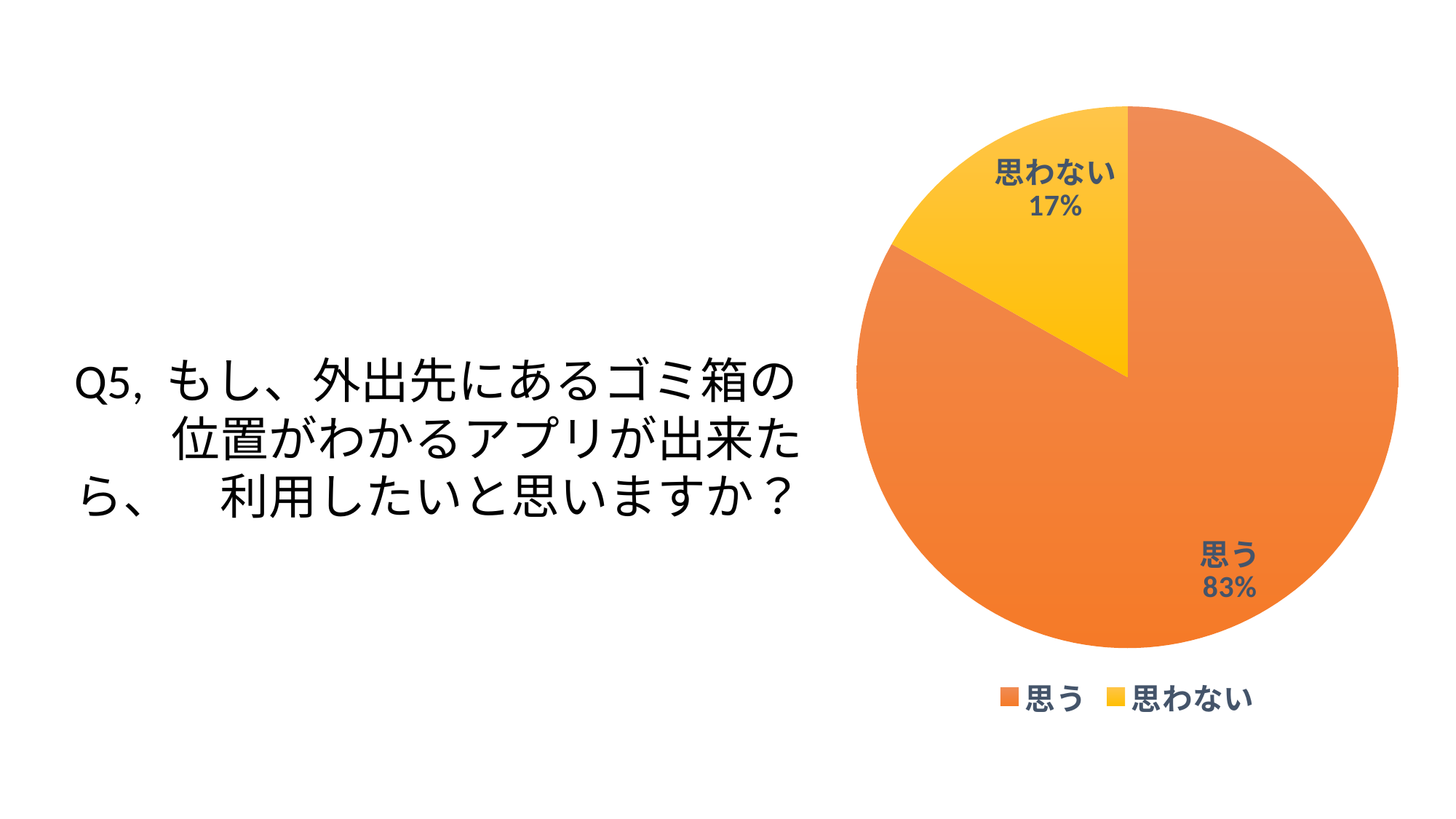
What percentage of the pie is labelled 思わない? 17% How many entries does the legend list? 2 Which legend entry is shown in yellow? 思わない What colour is the 思う slice in the pie chart? orange Which slice of the pie is the largest? 思う What share of the pie does the 思わない slice take? 17% What is the difference in percentage points between the 思う slice and the 思わない slice? 66 What kind of chart is shown on the slide? pie chart Which slice of the pie is the smallest? 思わない How many slices does the pie chart have? 2 Which slice is larger, 思う or 思わない? 思う What percentage of the pie is labelled 思う? 83%